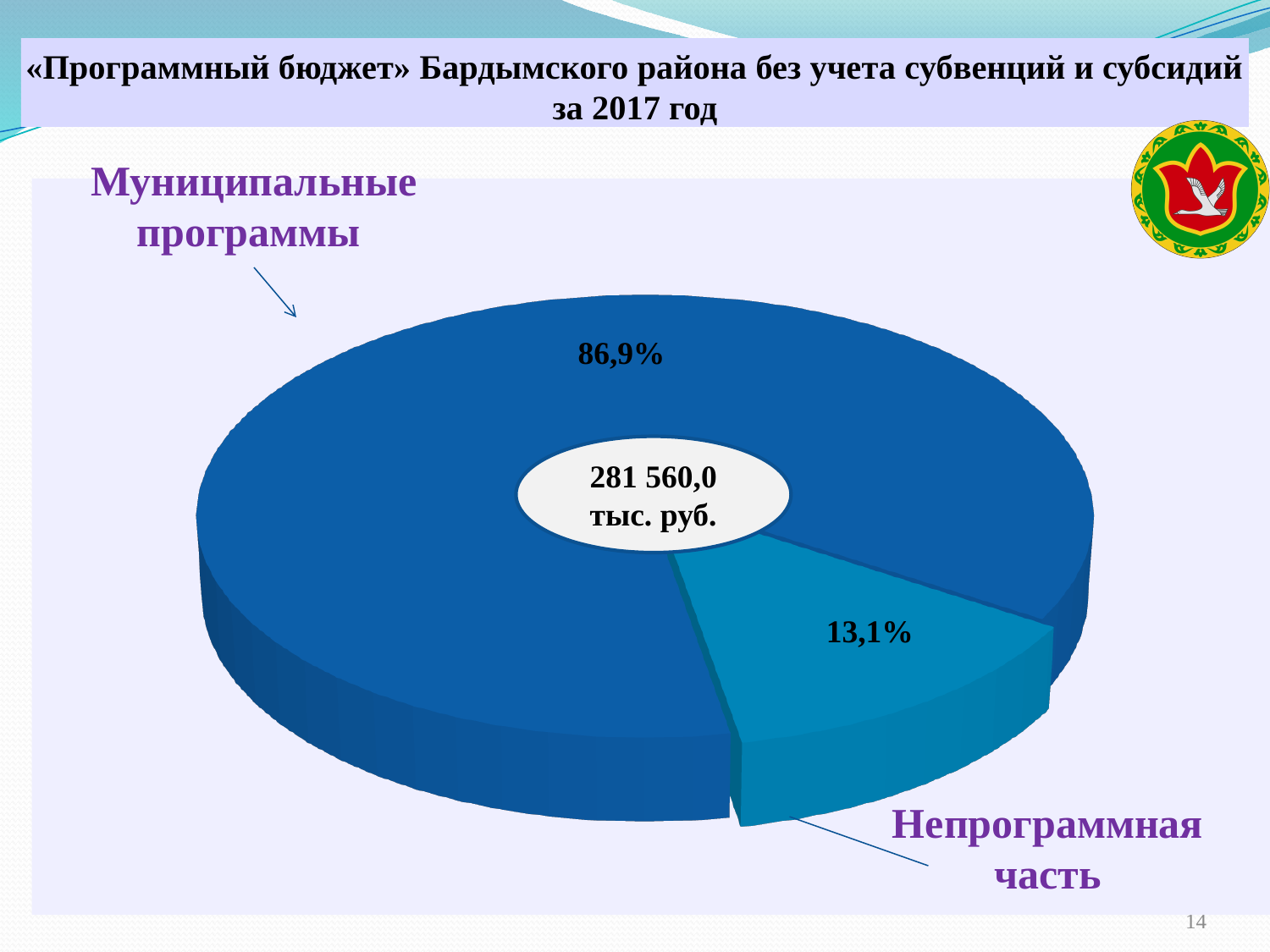
What total amount is printed in the centre of the pie chart? 281 560,0 тыс. руб. Which slice of the pie is the smallest? Непрограммная часть Which slice of the pie is the largest? Муниципальные программы Which is larger, the share for "Муниципальные программы" or the share for "Непрограммная часть"? Муниципальные программы What share of the pie does "Непрограммная часть" take? 13,1% What is the title of the slide containing the pie chart? «Программный бюджет» Бардымского района без учета субвенций и субсидий за 2017 год How many slices does the pie chart have? 2 What is the difference in percentage points between the "Муниципальные программы" slice and the "Непрограммная часть" slice? 73,8 What share of the pie does "Муниципальные программы" take? 86,9% What kind of chart is shown on the slide? pie chart